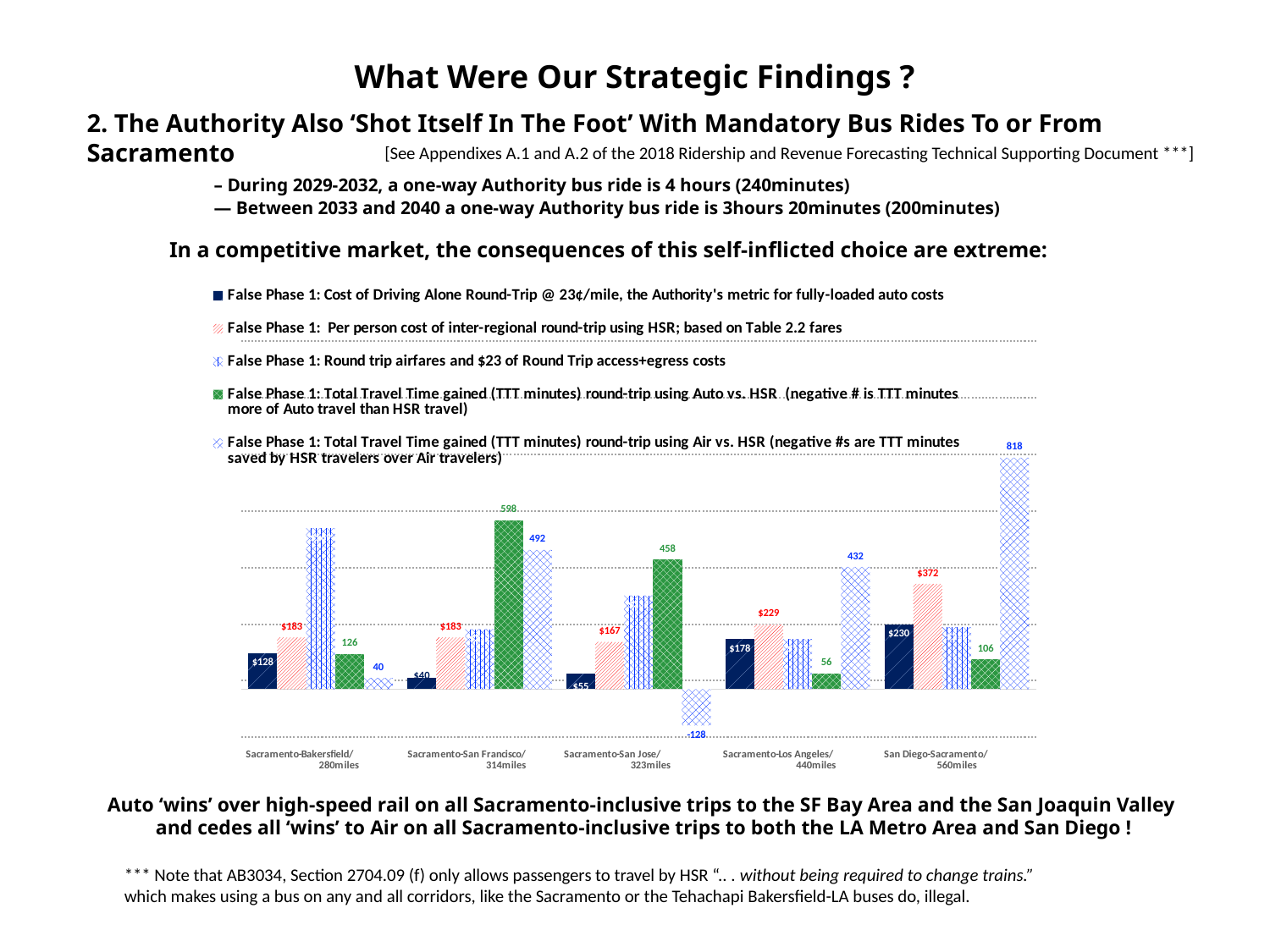
What is the cost of driving alone round-trip for Sacramento-Bakersfield? $128 Which corridor has the highest Total Travel Time gained using Auto vs. HSR? Sacramento-San Francisco What is the Total Travel Time gained round-trip using Auto vs. HSR for Sacramento-San Francisco? 598 What is the per person cost of an inter-regional round-trip using HSR for San Diego-Sacramento? $372 What is the Total Travel Time gained round-trip using Air vs. HSR for Sacramento-San Jose? -128 Which corridor has the lowest Total Travel Time gained using Air vs. HSR? Sacramento-San Jose Which is larger, the Total Travel Time gained using Auto vs. HSR for Sacramento-San Jose or for Sacramento-Los Angeles? Sacramento-San Jose Which corridor has the lowest cost of driving alone round-trip? Sacramento-San Francisco How many series does the chart legend list? 5 How many corridors are shown on the x axis of the chart? 5 For Sacramento-Los Angeles, how much more is the per person HSR round-trip cost than the cost of driving alone round-trip? $51 Which corridor has the highest Total Travel Time gained using Air vs. HSR? San Diego-Sacramento